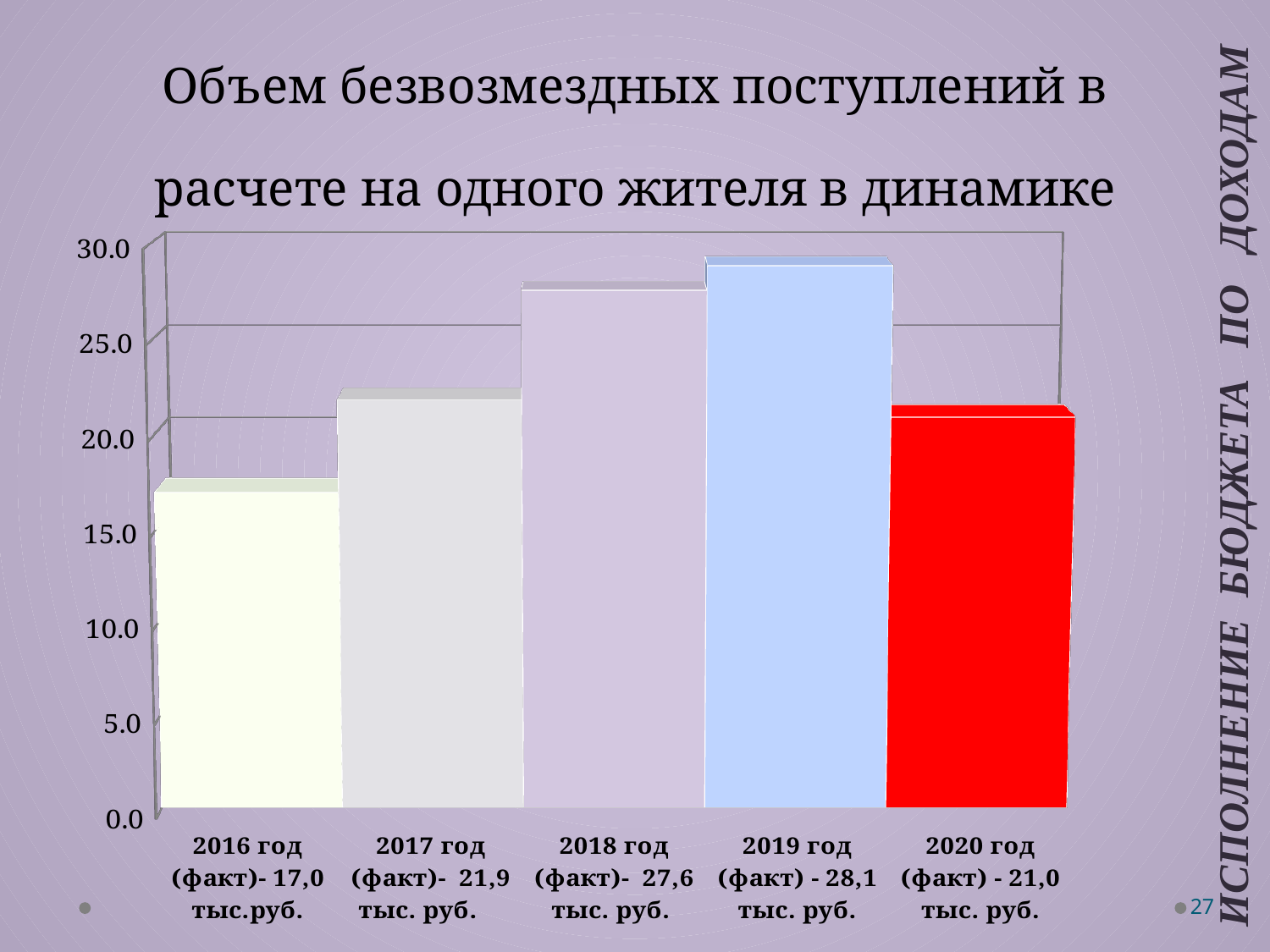
What is the value for 2016 год (факт)? 17,0 тыс.руб. What is the difference between the values for 2019 год and 2018 год? 0,5 тыс. руб. Which is larger, the value for 2017 год or the value for 2020 год? 2017 год Which year has the lowest value? 2016 год Is the value for 2018 год greater or less than 25.0? greater What is the value for 2018 год (факт)? 27,6 тыс. руб. How many years are shown on the chart? 5 What is the difference between the values for 2017 год and 2016 год? 4,9 тыс. руб. Which year has the highest value? 2019 год What kind of chart is shown on the slide? Bar chart What is the value for 2020 год (факт)? 21,0 тыс. руб. What is the title of the chart? Объем безвозмездных поступлений в расчете на одного жителя в динамике